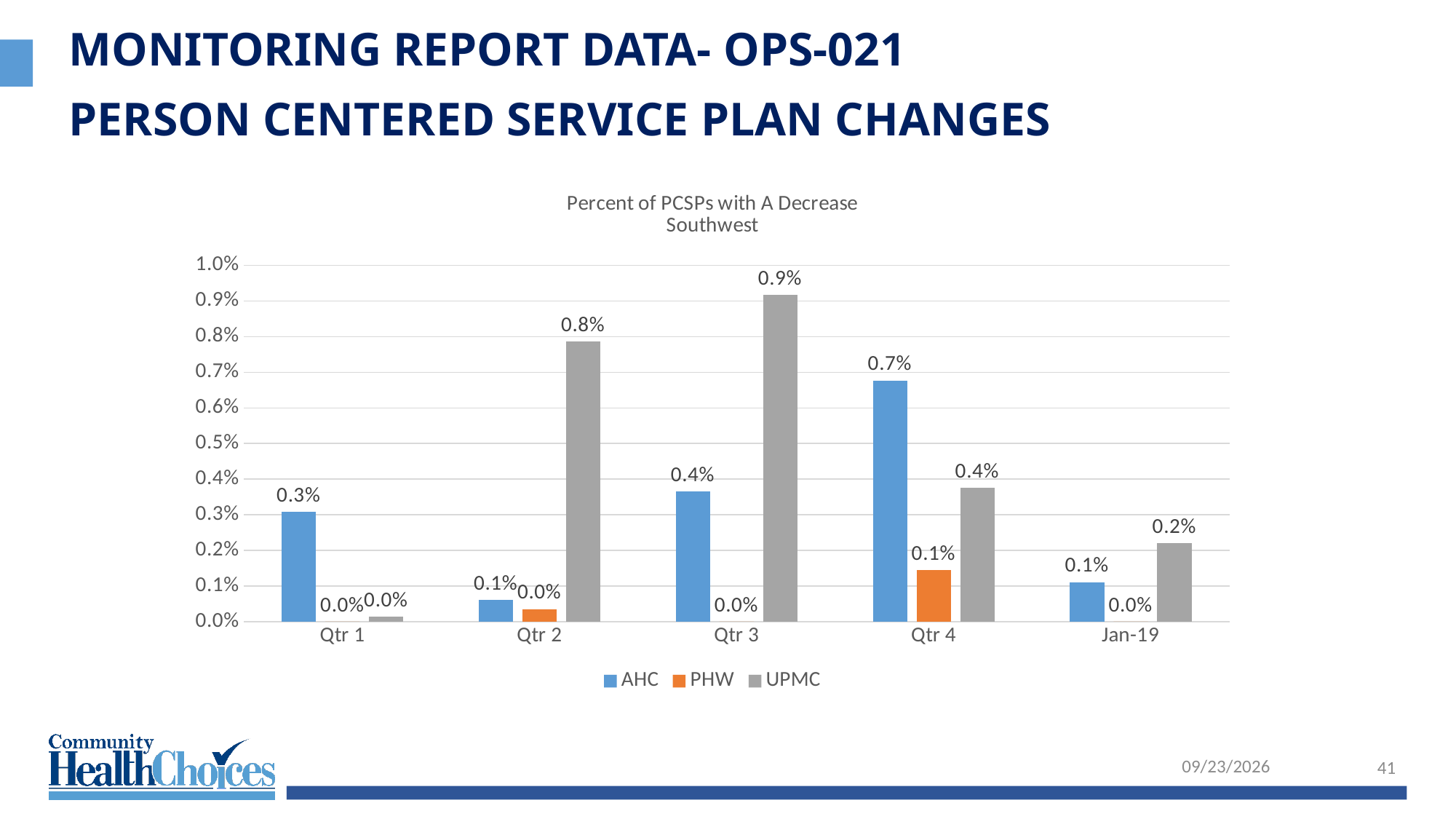
How many series does the legend list? 3 In Qtr 2, which is larger, the AHC value or the UPMC value? UPMC Which series has the tallest bar in Qtr 4? AHC What is the value for UPMC in Jan-19? 0.2% In which period is the AHC value highest? Qtr 4 How many periods are shown on the x axis? 5 What is the value for AHC in Qtr 4? 0.7% What kind of chart is shown on the slide? bar chart In which period is the UPMC value highest? Qtr 3 What is the value for UPMC in Qtr 2? 0.8% What is the value for PHW in Qtr 4? 0.1% Is the value for UPMC in Qtr 3 greater or less than 0.5%? greater